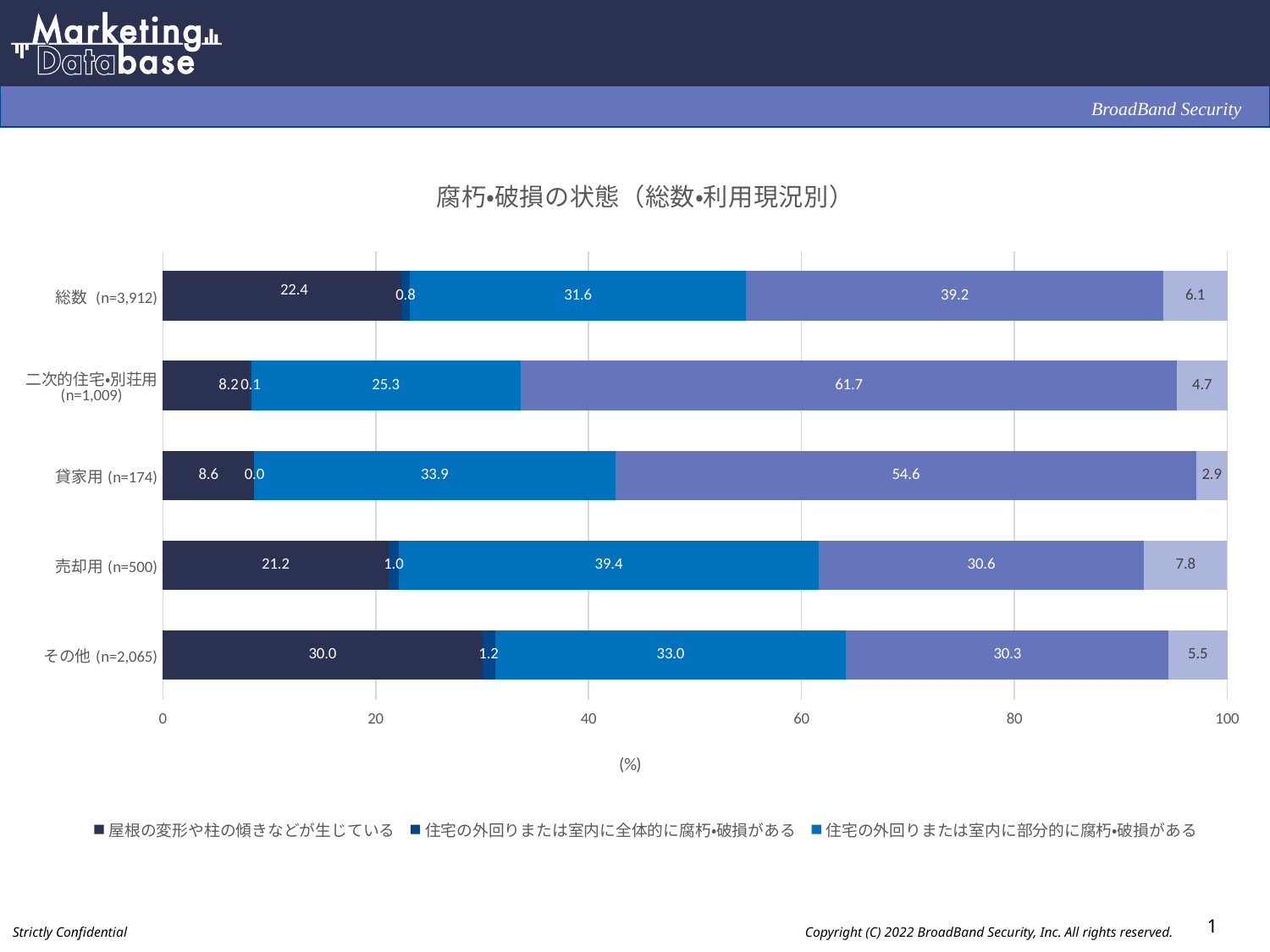
How many categories (rows) are plotted in the chart? 5 What is the value of 住宅の外回りまたは室内に全体的に腐朽•破損がある for 貸家用 (n=174)? 0.0 Which has the larger value for 住宅の外回りまたは室内に全体的に腐朽•破損がある, 売却用 (n=500) or その他 (n=2,065)? その他 (n=2,065) Which category has the lowest value for 屋根の変形や柱の傾きなどが生じている? 二次的住宅•別荘用 (n=1,009) What is the value of 住宅の外回りまたは室内に部分的に腐朽•破損がある for 二次的住宅•別荘用 (n=1,009)? 25.3 What is the value of 屋根の変形や柱の傾きなどが生じている for 総数 (n=3,912)? 22.4 Which category has the highest value for 屋根の変形や柱の傾きなどが生じている? その他 (n=2,065) How many series does the legend list? 3 What is the value of 住宅の外回りまたは室内に部分的に腐朽•破損がある for 売却用 (n=500)? 39.4 What is the difference in 住宅の外回りまたは室内に部分的に腐朽•破損がある between 売却用 (n=500) and 総数 (n=3,912)? 7.8 What is the title of the chart? 腐朽•破損の状態（総数•利用現況別） What kind of chart is shown on the slide? bar chart